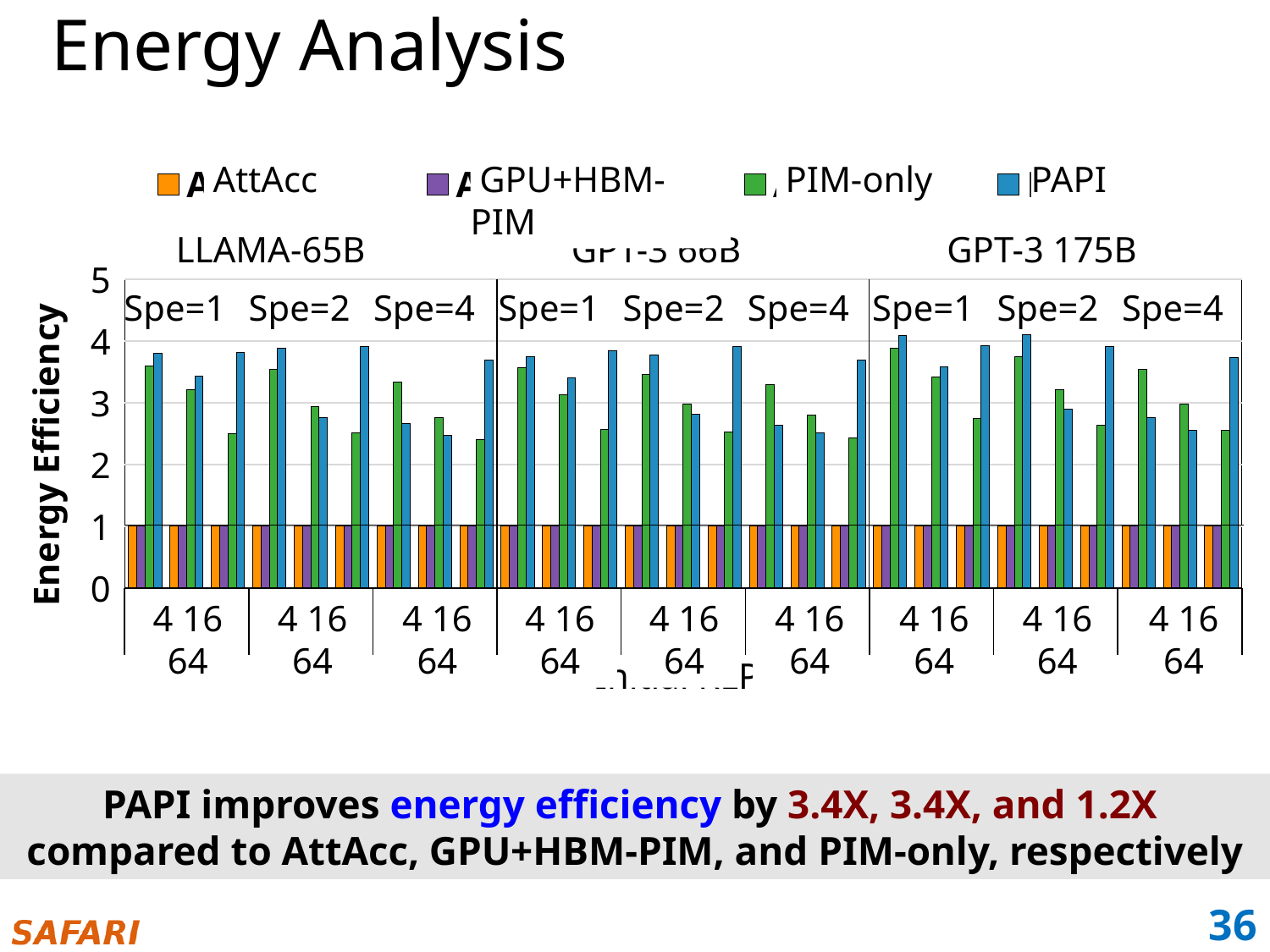
What is the energy efficiency value for AttAcc in LLAMA-65B, Spe=1, batch size 4? 1 How many series does the legend list? 4 What kind of chart is shown on the slide? bar chart For LLAMA-65B, Spe=1, does the PIM-only value rise or fall as batch size increases from 4 to 64? fall What is the title of the y axis? Energy Efficiency How many batch sizes are shown within each Spe group on the x axis? 3 Is the PIM-only value for GPT-3 175B, Spe=4, batch size 64 greater or less than 3? less For LLAMA-65B, Spe=1, batch size 64, which is larger: PAPI or PIM-only? PAPI Is the PIM-only value for LLAMA-65B, Spe=1, batch size 64 greater or less than 3? less Is the PAPI value for LLAMA-65B, Spe=1, batch size 4 greater or less than 3? greater What is the energy efficiency value for GPU+HBM-PIM in GPT-3 175B, Spe=4, batch size 64? 1 Which series has the highest energy efficiency for LLAMA-65B, Spe=2, batch size 64? PAPI